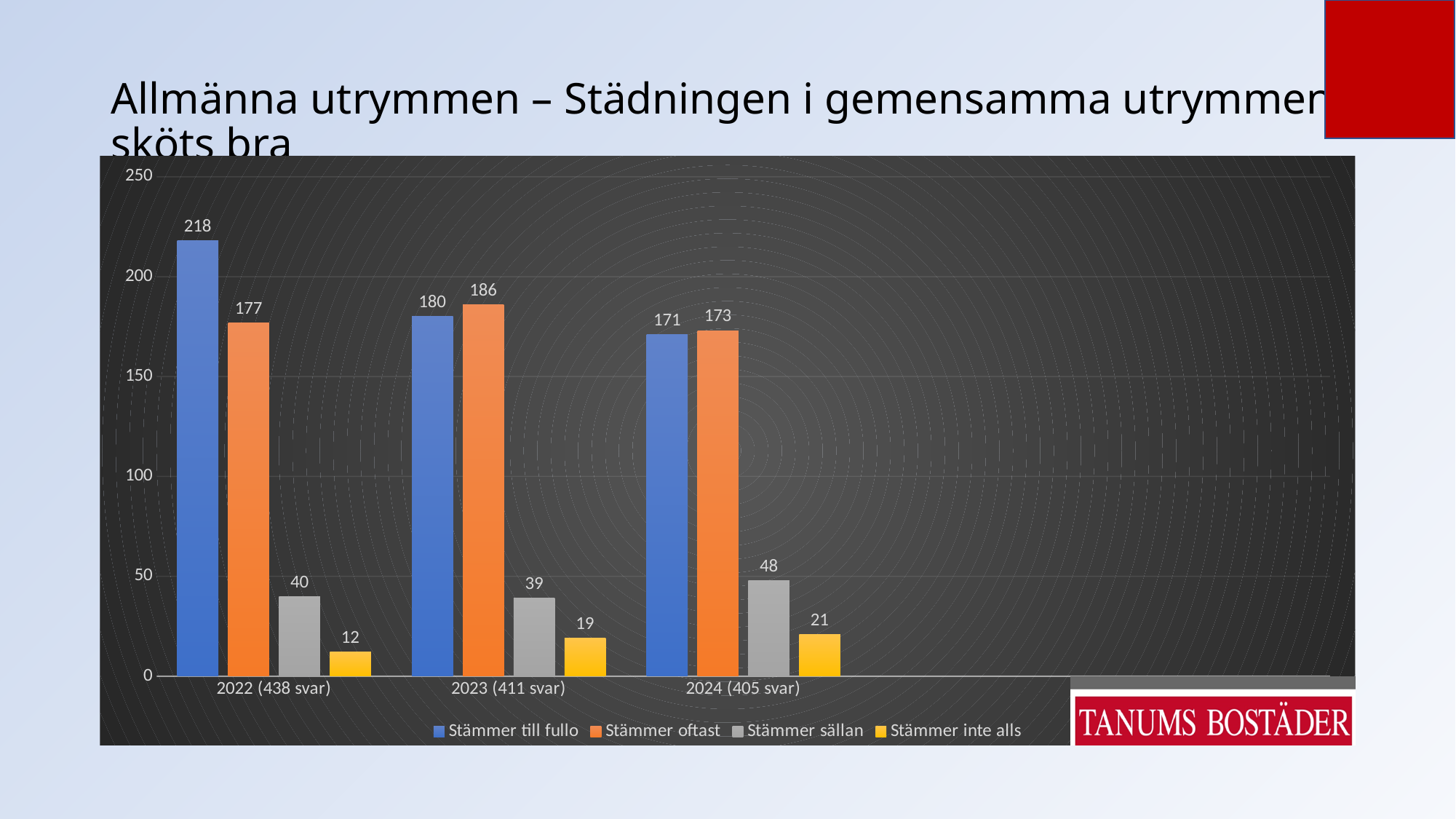
Which category has the highest value for "Stämmer till fullo"? 2022 (438 svar) How many categories are shown on the x axis? 3 How many series does the legend list? 4 What is the value for "Stämmer till fullo" in 2022 (438 svar)? 218 Which is larger in 2023 (411 svar): "Stämmer till fullo" or "Stämmer oftast"? Stämmer oftast What is the value for "Stämmer sällan" in 2022 (438 svar)? 40 What is the value for "Stämmer oftast" in 2023 (411 svar)? 186 Does the value for "Stämmer till fullo" rise or fall from 2022 to 2024? Fall What is the value for "Stämmer inte alls" in 2024 (405 svar)? 21 What kind of chart is shown on the slide? Bar chart Which category has the lowest value for "Stämmer inte alls"? 2022 (438 svar) What is the difference between "Stämmer till fullo" in 2022 (438 svar) and in 2024 (405 svar)? 47